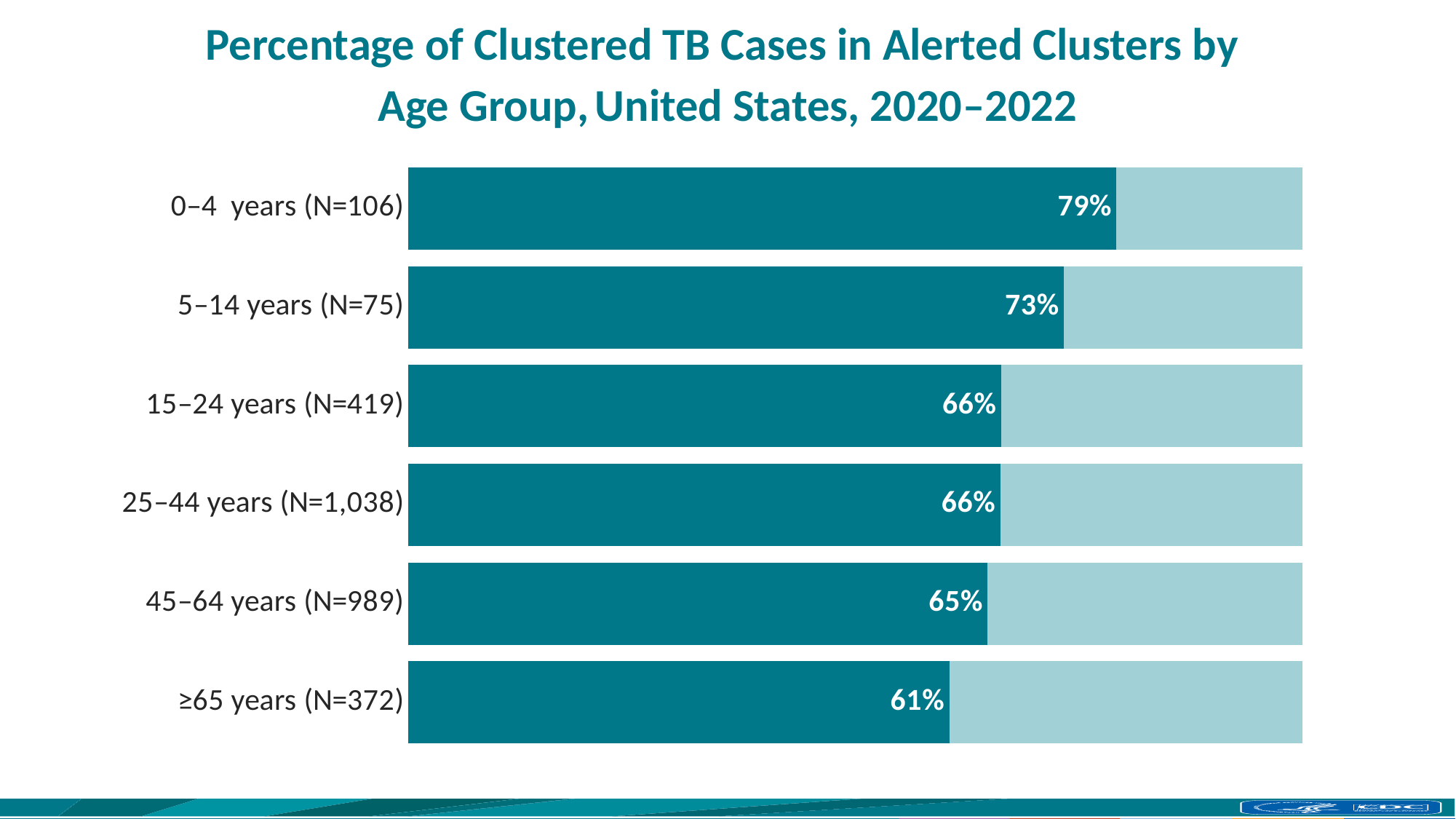
How many age groups are shown in the chart? 6 What is the difference in percentage points between the 0–4 years and ≥65 years age groups? 18 What percentage of clustered TB cases were in alerted clusters for the 0–4 years age group? 79% What percentage is shown for the ≥65 years age group? 61% Do the percentages rise or fall as age group increases from top to bottom? Fall Which has a higher percentage, the 5–14 years group or the 45–64 years group? 5–14 years Which age group has the highest percentage of clustered TB cases in alerted clusters? 0–4 years What is the value shown for the 5–14 years age group? 73% Which age group has the lowest percentage of clustered TB cases in alerted clusters? ≥65 years What is the value for the 45–64 years age group? 65% What kind of chart is shown on the slide? Bar chart What is the N value shown for the 25–44 years age group? 1,038